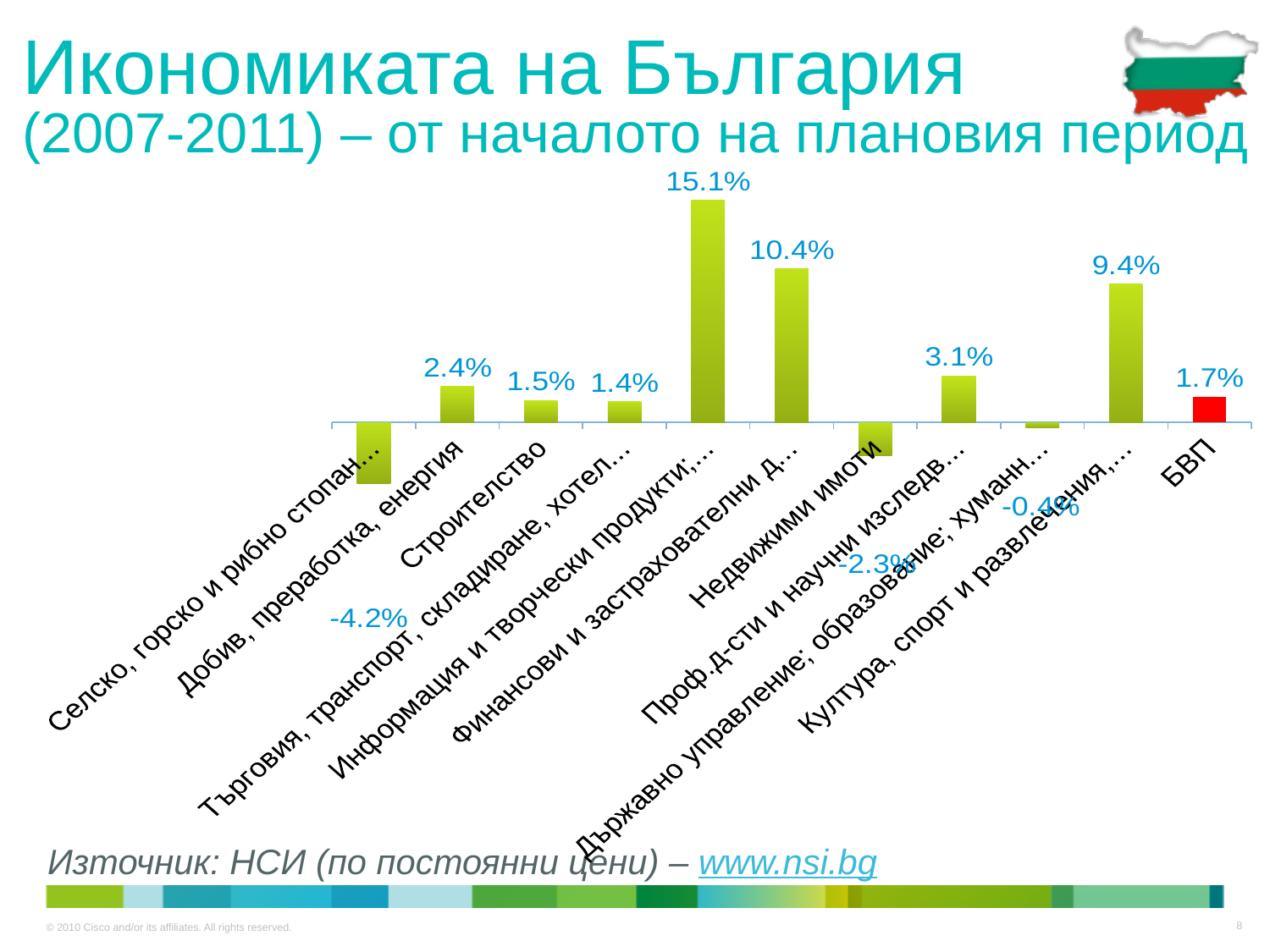
What is the difference between the value for Добив, преработка, енергия and the value for Строителство? 0.9 percentage points Which category has the lowest value on the chart? Селско, горско и рибно стопанство (-4.2%) Which is larger: the value for Добив, преработка, енергия or the value for Строителство? Добив, преработка, енергия What kind of chart is shown on the slide? Bar chart How many categories on the chart have a negative value? 3 What is the value shown for Недвижими имоти? -2.3% How many categories are plotted on the chart? 11 What colour is the bar for БВП? Red Which category has the highest value on the chart? Информация и творчески продукти (15.1%) What is the value shown for Строителство? 1.5% What is the value shown for Добив, преработка, енергия? 2.4% What is the value shown for БВП? 1.7%